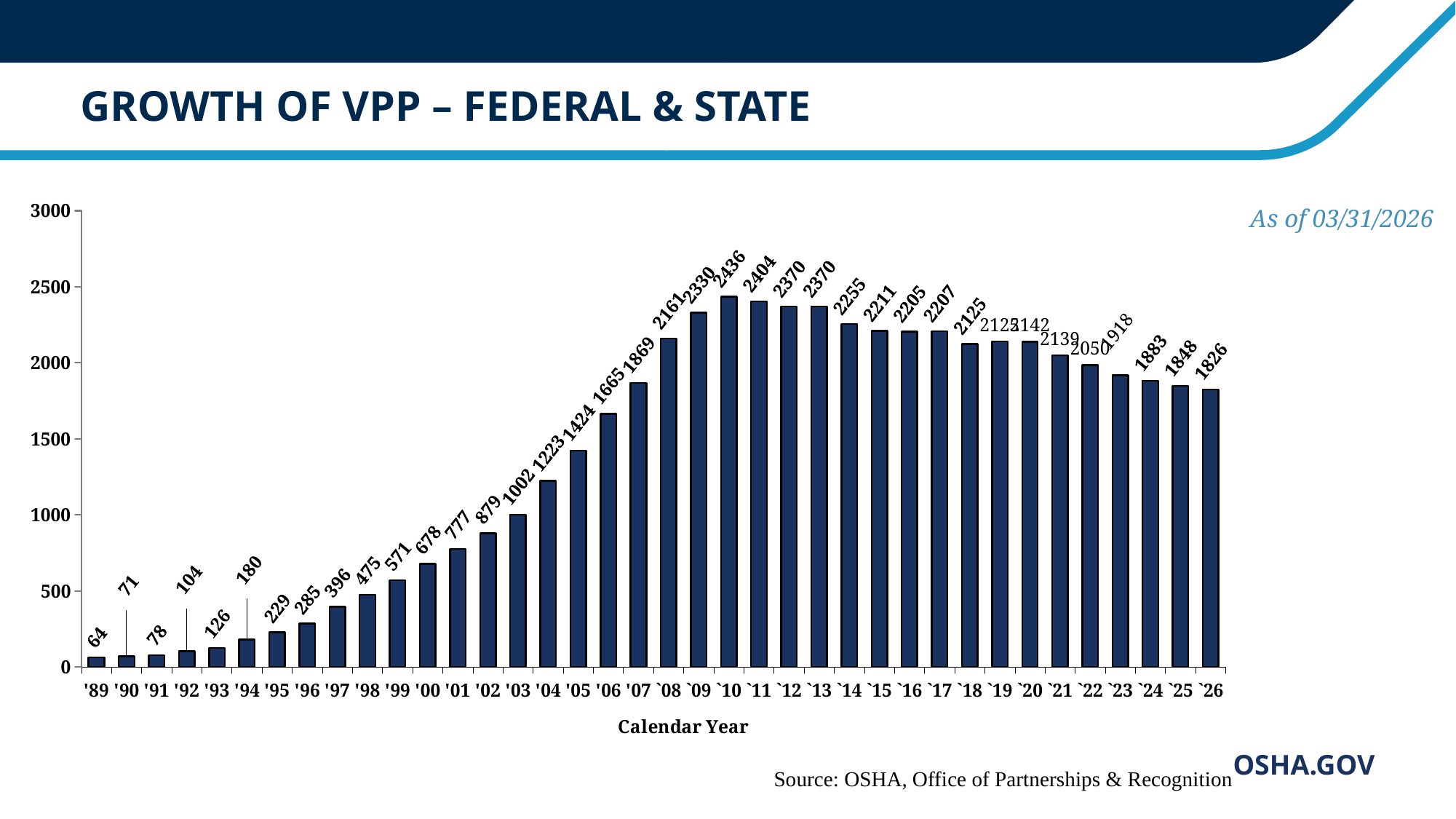
What is the difference between the values for '25 and '26? 22 Do the values rise or fall from '89 to '10? rise What kind of chart is this? bar chart What is the value for '89? 64 How many years are shown on the x axis? 38 What is the difference between the values for '10 and '26? 610 Which year has the highest value? '10 What is the value for '10? 2436 What is the value for '00? 678 What is the value for '26? 1826 Which is larger, the value for '05 or the value for '06? '06 Which year has the lowest value? '89